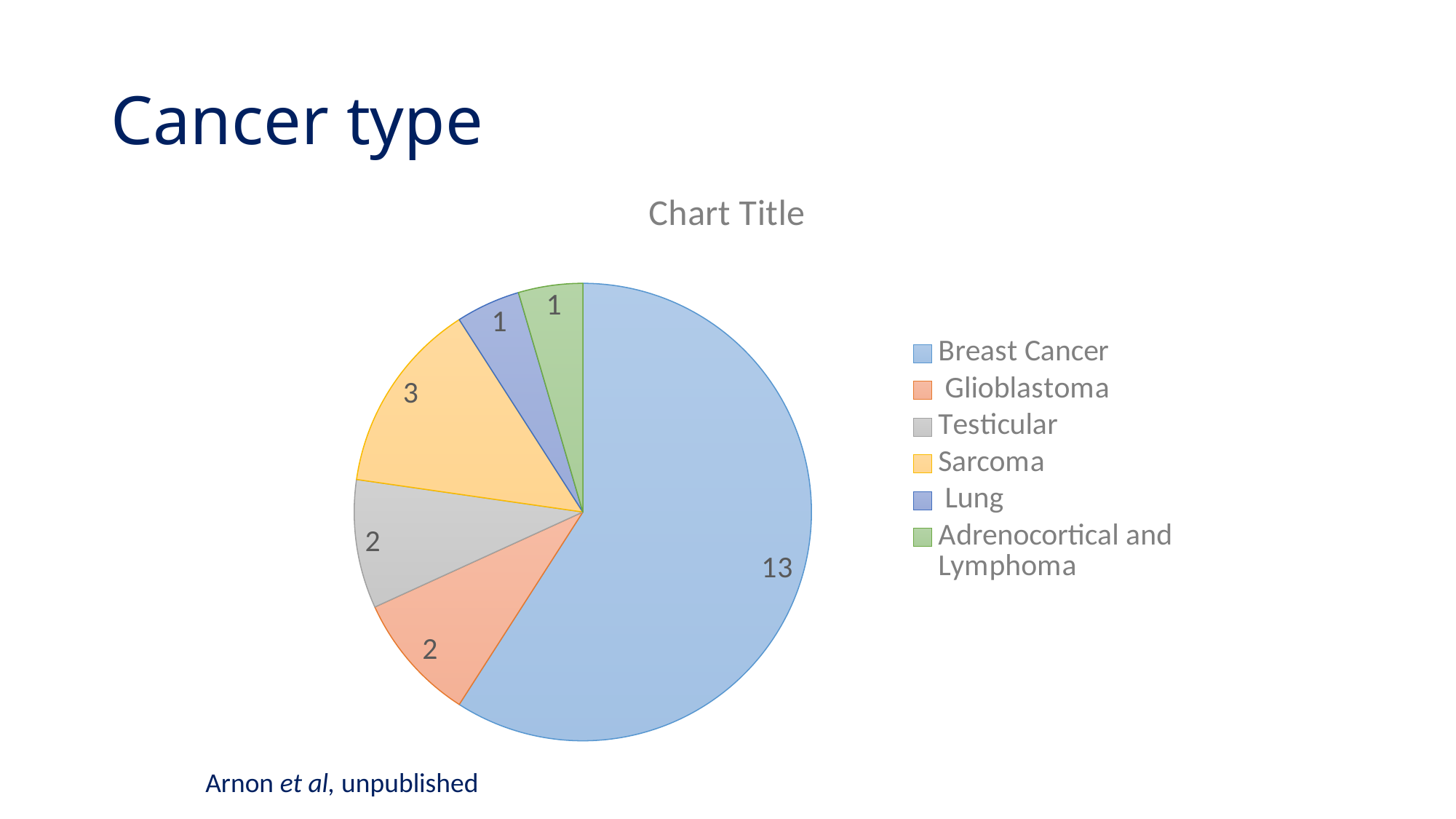
What is the difference between the values for Sarcoma and Testicular? 1 Which category has the largest slice in the pie chart? Breast Cancer What is the value for Breast Cancer in the pie chart? 13 Which legend entry is shown in green? Adrenocortical and Lymphoma What is the value for Lung in the pie chart? 1 What is the total of all the values in the pie chart? 22 What is the difference between the values for Breast Cancer and Sarcoma? 10 Which is larger, the value for Sarcoma or the value for Lung? Sarcoma What is the value for Sarcoma in the pie chart? 3 What is the value for Glioblastoma in the pie chart? 2 How many categories are shown in the pie chart? 6 What type of chart is shown on the slide? Pie chart